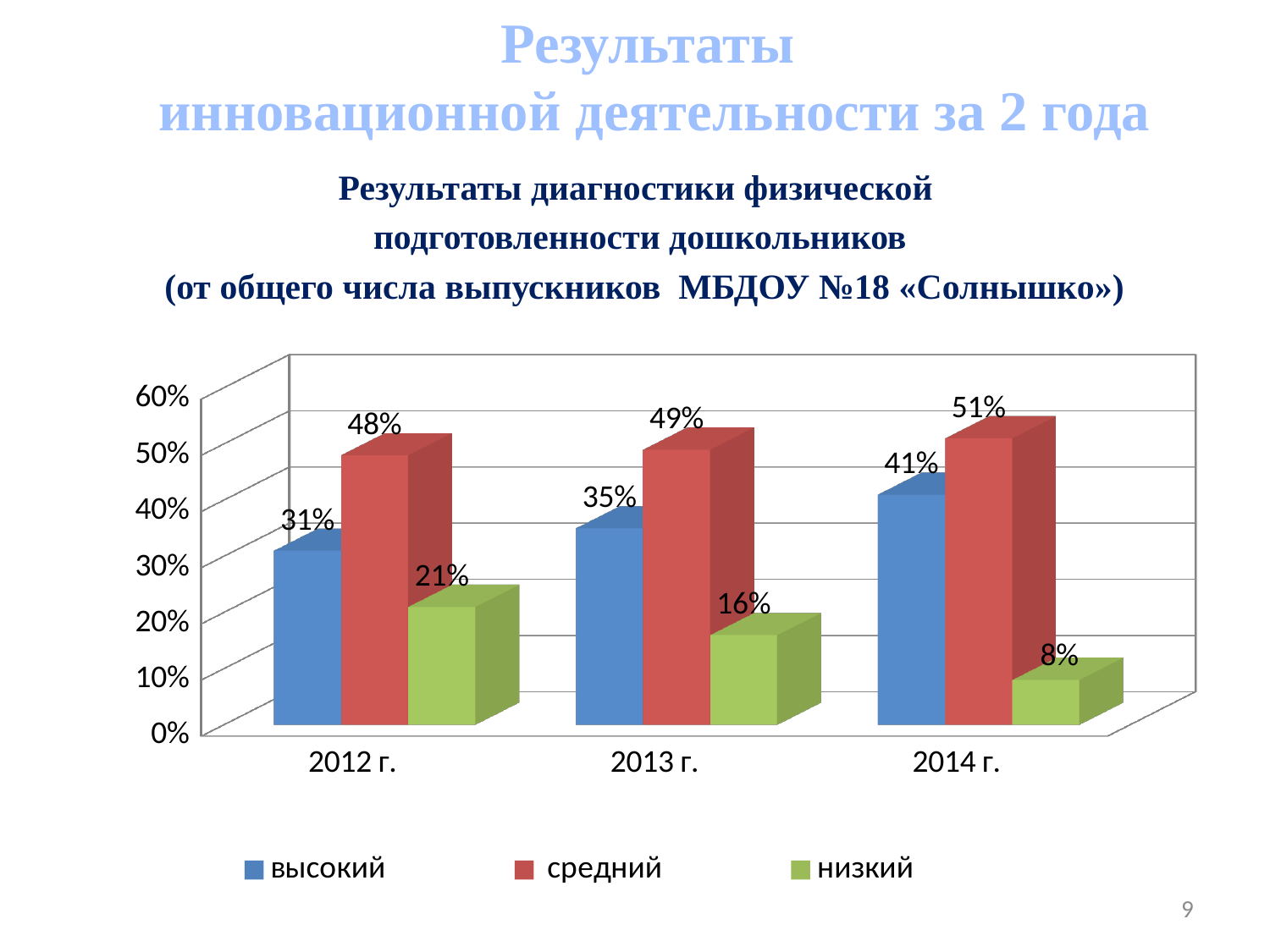
What is the difference between the высокий values for 2014 г. and 2012 г.? 10% Which is larger in 2013 г.: высокий or средний? средний In which year is the value for высокий the highest? 2014 г. Does the value for низкий rise or fall from 2012 г. to 2014 г.? fall What is the value for низкий in 2013 г.? 16% How many years are shown on the x axis? 3 What is the value for средний in 2014 г.? 51% What kind of chart is shown on the slide? bar chart How many series does the legend list? 3 What is the value for высокий in 2012 г.? 31% Is the value for низкий in 2012 г. greater or less than 20%? greater In which year is the value for низкий the lowest? 2014 г.